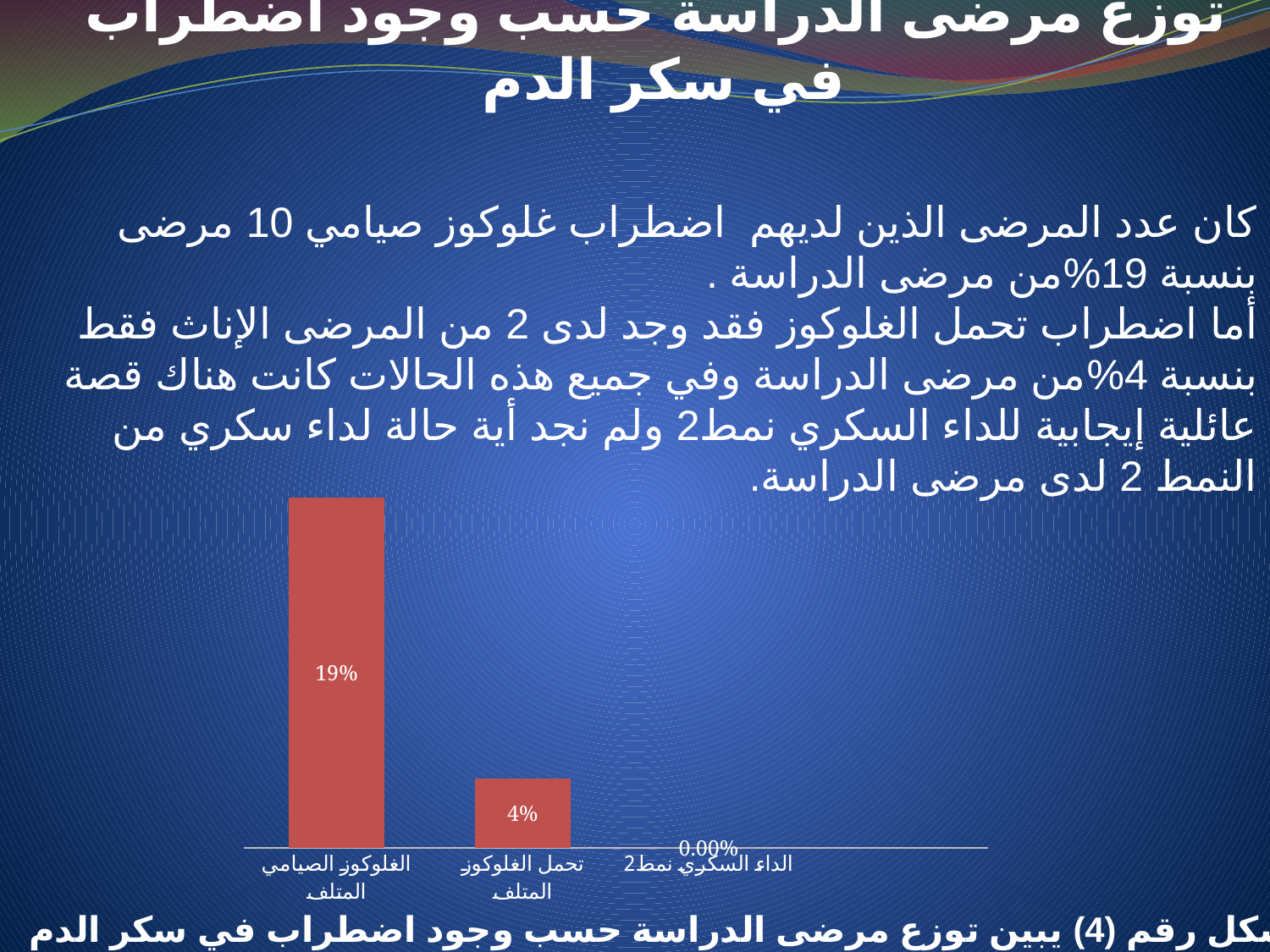
How many categories are plotted in the bar chart? 3 What colour are the bars in the chart? red What is the value shown for الداء السكري نمط2? 0.00% Which category has the highest value in the chart? الغلوكوز الصيامي المتلف What figure number is given in the caption below the chart? 4 Which is larger, the value for الغلوكوز الصيامي المتلف or the value for تحمل الغلوكوز المتلف? الغلوكوز الصيامي المتلف Which category has the lowest value in the chart? الداء السكري نمط2 What is the difference between the values for الغلوكوز الصيامي المتلف and تحمل الغلوكوز المتلف? 15% Do the bar values rise or fall from left to right across the categories? fall What type of chart is shown on the slide? bar chart What is the value shown for الغلوكوز الصيامي المتلف? 19% What is the value shown for تحمل الغلوكوز المتلف? 4%